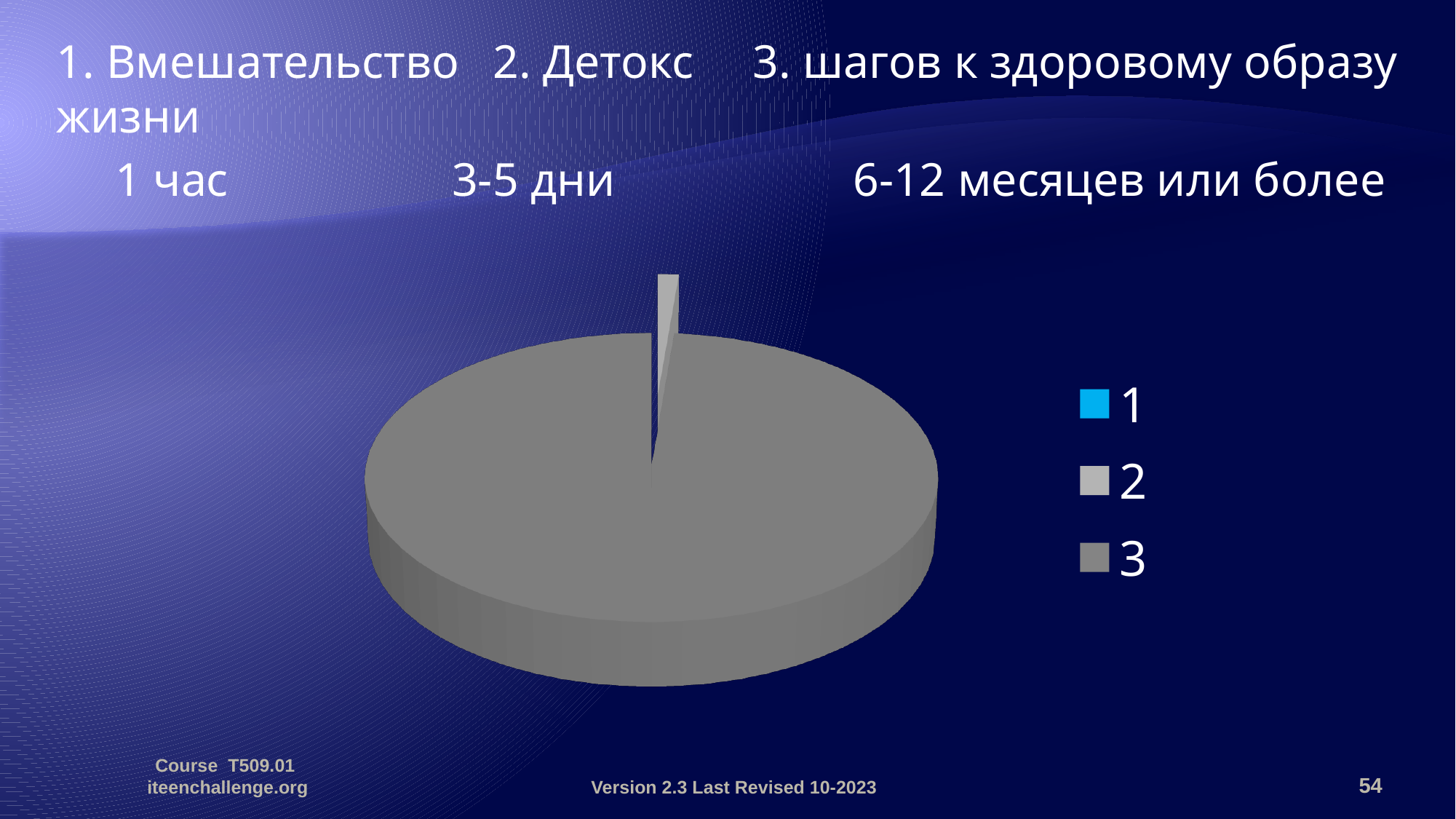
Which category has the largest slice of the pie? 3 What colour is the slice for category 3 in the pie chart? dark gray What kind of chart is shown on the slide? pie chart How many entries does the chart legend list? 3 Does the slice for category 3 take up more or less than half of the pie? more Which slice is larger, category 2 or category 3? 3 Which legend entry is shown in blue? 1